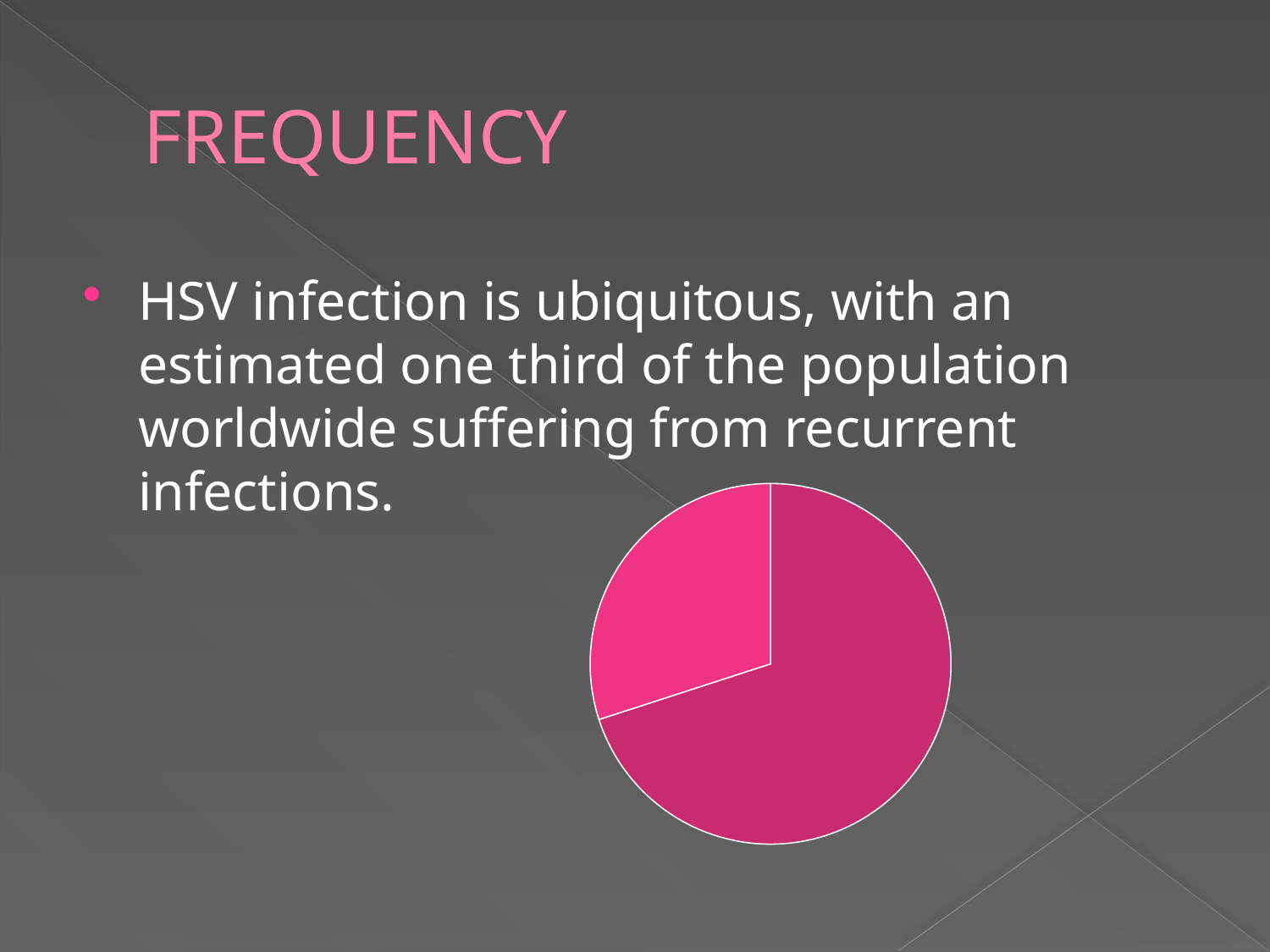
Does the pie chart show any data labels on its slices? No How many slices does the pie chart have? 2 Does the pie chart display a legend? No Which slice of the pie chart is larger, the darker magenta slice or the lighter pink slice? the darker magenta slice What kind of chart is shown on the slide? pie chart Which slice of the pie chart is the smallest? the lighter pink slice